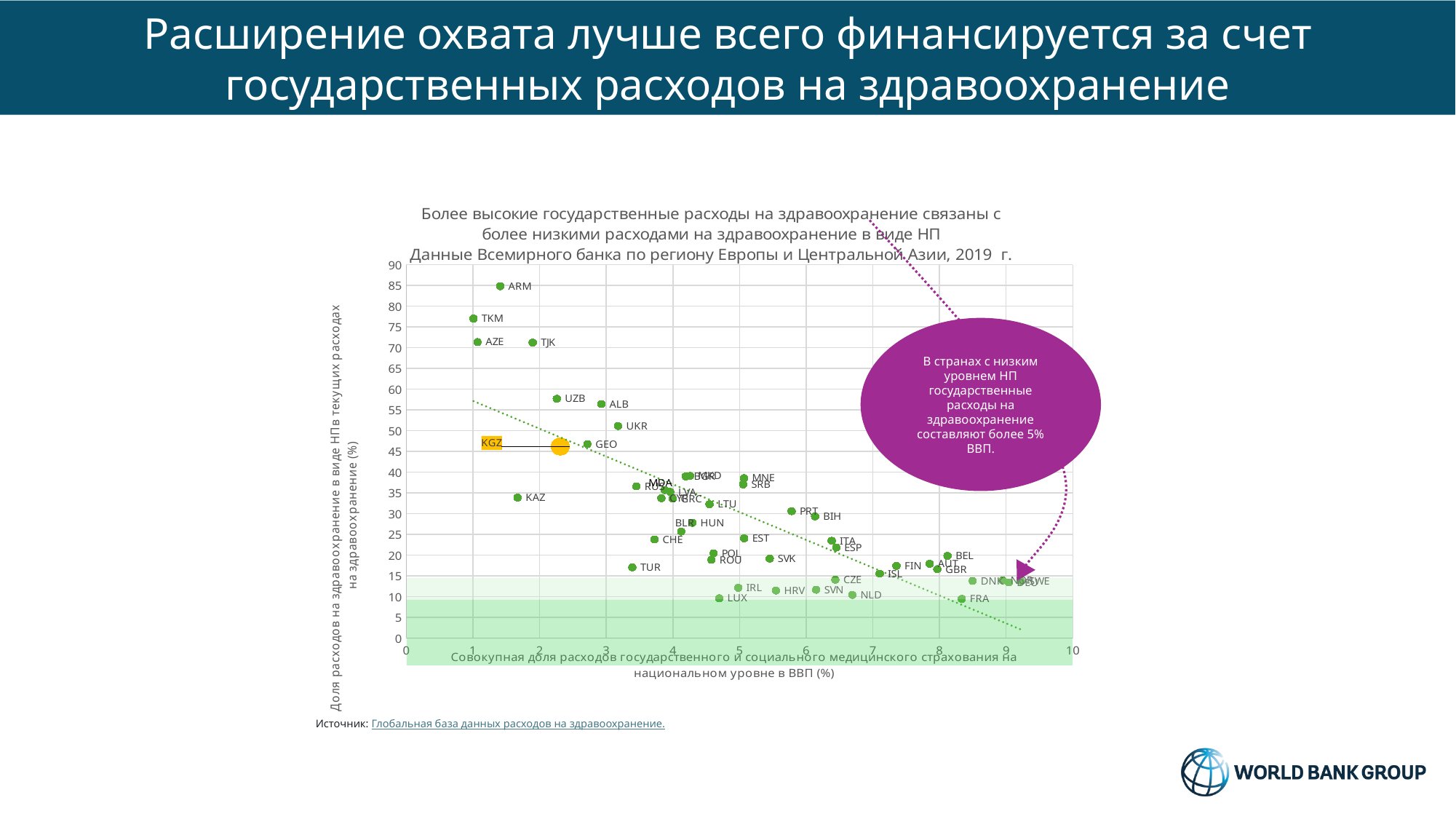
Is the out-of-pocket share for KAZ greater or less than 40? less Which country is highlighted with an orange marker on the chart? KGZ Which country has the highest share of out-of-pocket (НП) spending in current health expenditure? ARM Is the out-of-pocket share for ARM greater or less than 80? greater What is the maximum value shown on the x axis? 10 What kind of chart is shown on the slide? scatter plot Is the out-of-pocket share for TUR greater or less than 20? less As the share of government and social health insurance spending in GDP increases along the x axis, does the share of out-of-pocket spending generally rise or fall? fall Which has a higher out-of-pocket share, KAZ or UKR? UKR Which has a higher out-of-pocket share, ARM or TKM? ARM